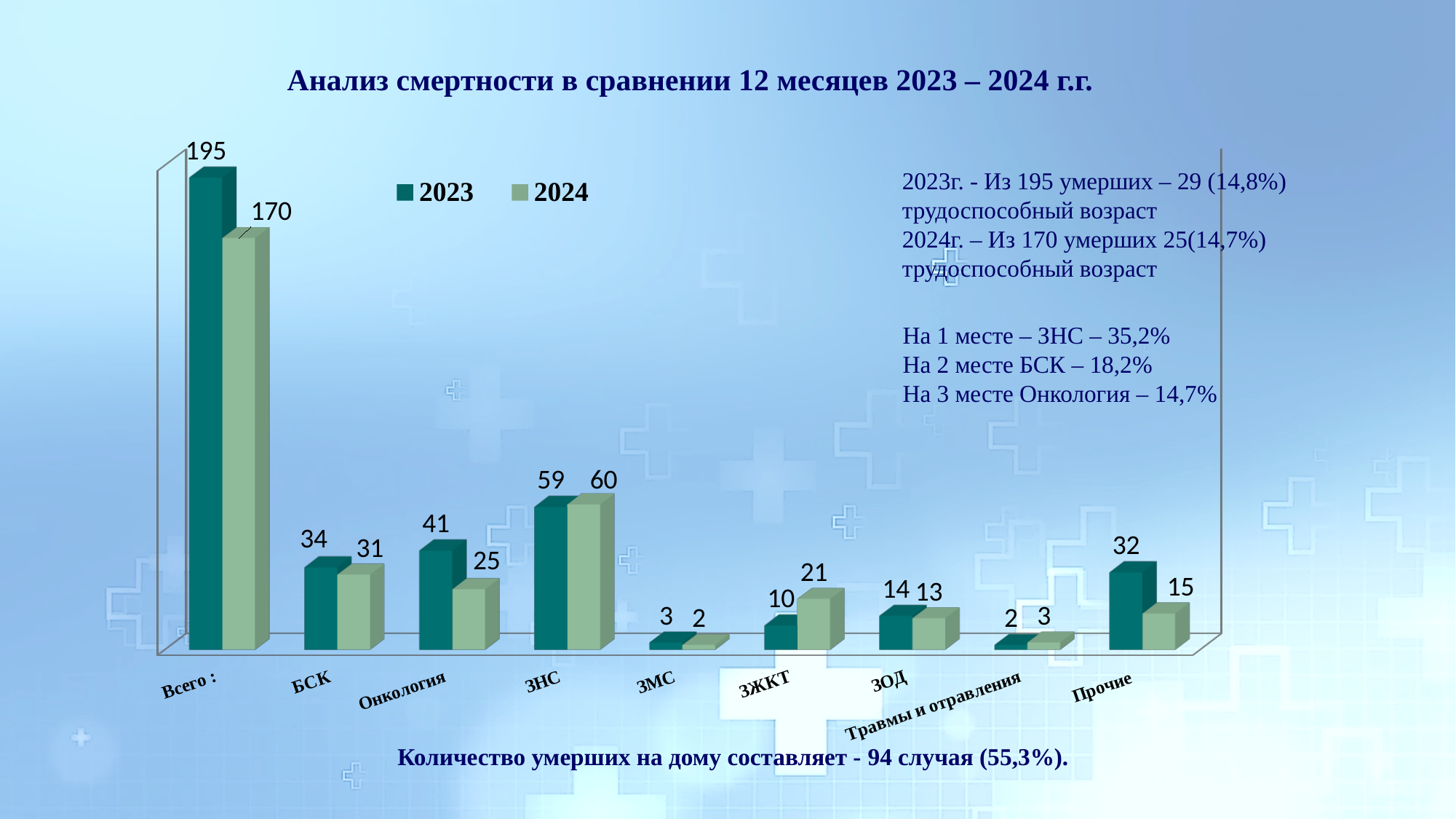
What is the 2024 value for Онкология? 25 How many categories are shown on the x axis? 9 Excluding the Всего total, which category has the highest 2024 value? ЗНС What is the difference between the 2023 and 2024 values for Всего? 25 How many series does the legend list? 2 What is the 2023 value for ЗНС? 59 What are the two series named in the legend? 2023 and 2024 Which is larger for ЗЖКТ, the 2023 value or the 2024 value? 2024 What kind of chart is shown on the slide? Bar chart What is the 2023 value for Прочие? 32 What is the 2024 value for ЗЖКТ? 21 Which category has the lowest 2023 value? Травмы и отравления